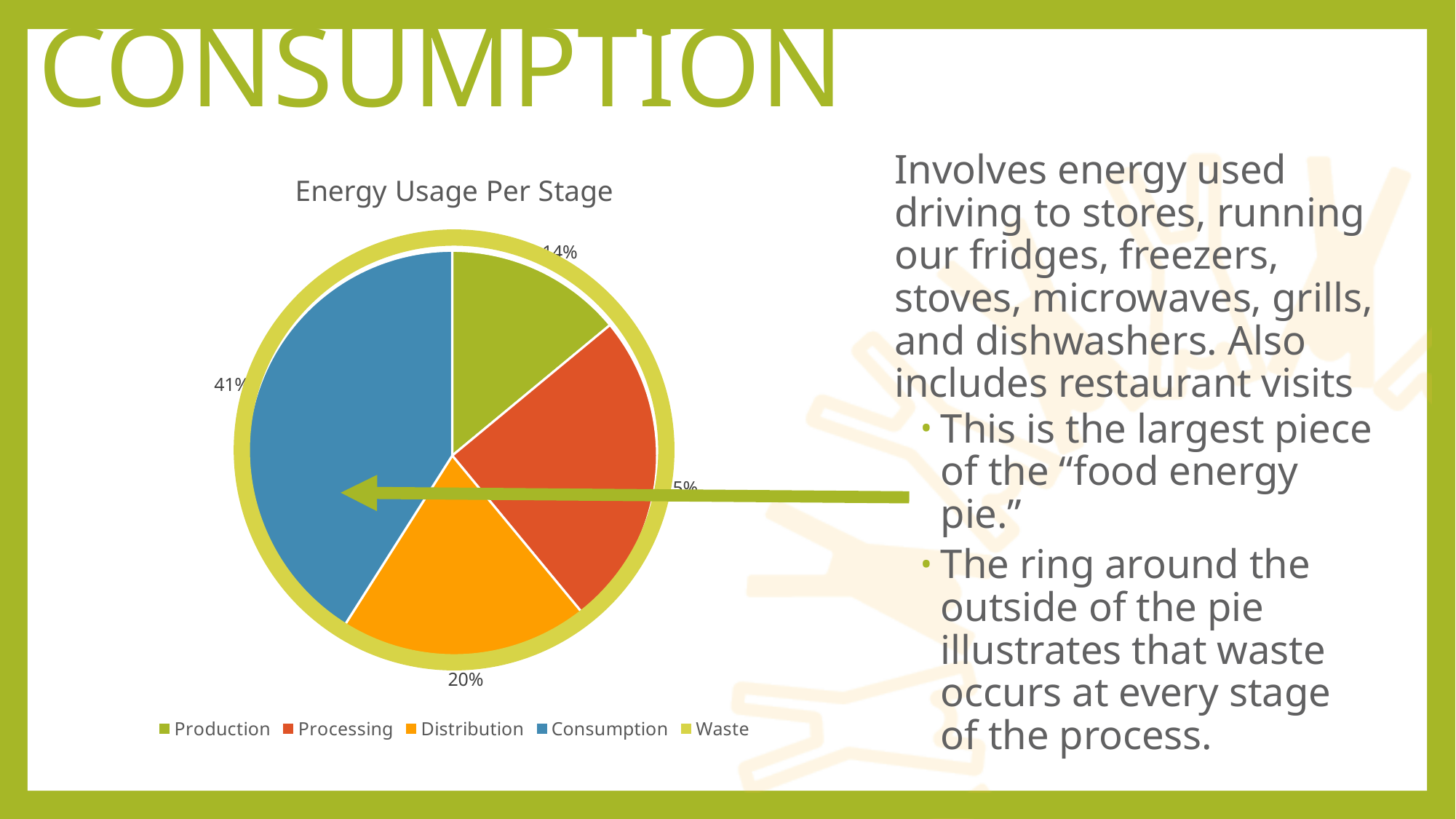
What percentage is shown for the Consumption slice? 41% What is the difference between the Consumption share and the Distribution share? 21 percentage points What is the title of the chart? Energy Usage Per Stage Which stage has the largest slice of the pie? Consumption What kind of chart is shown on the slide? pie chart What colour is the Consumption slice? blue What percentage is shown for the Distribution slice? 20% Which of the pie slices is the smallest? Production How many entries does the chart's legend list? 5 Which is larger, the Consumption slice or the Distribution slice? Consumption